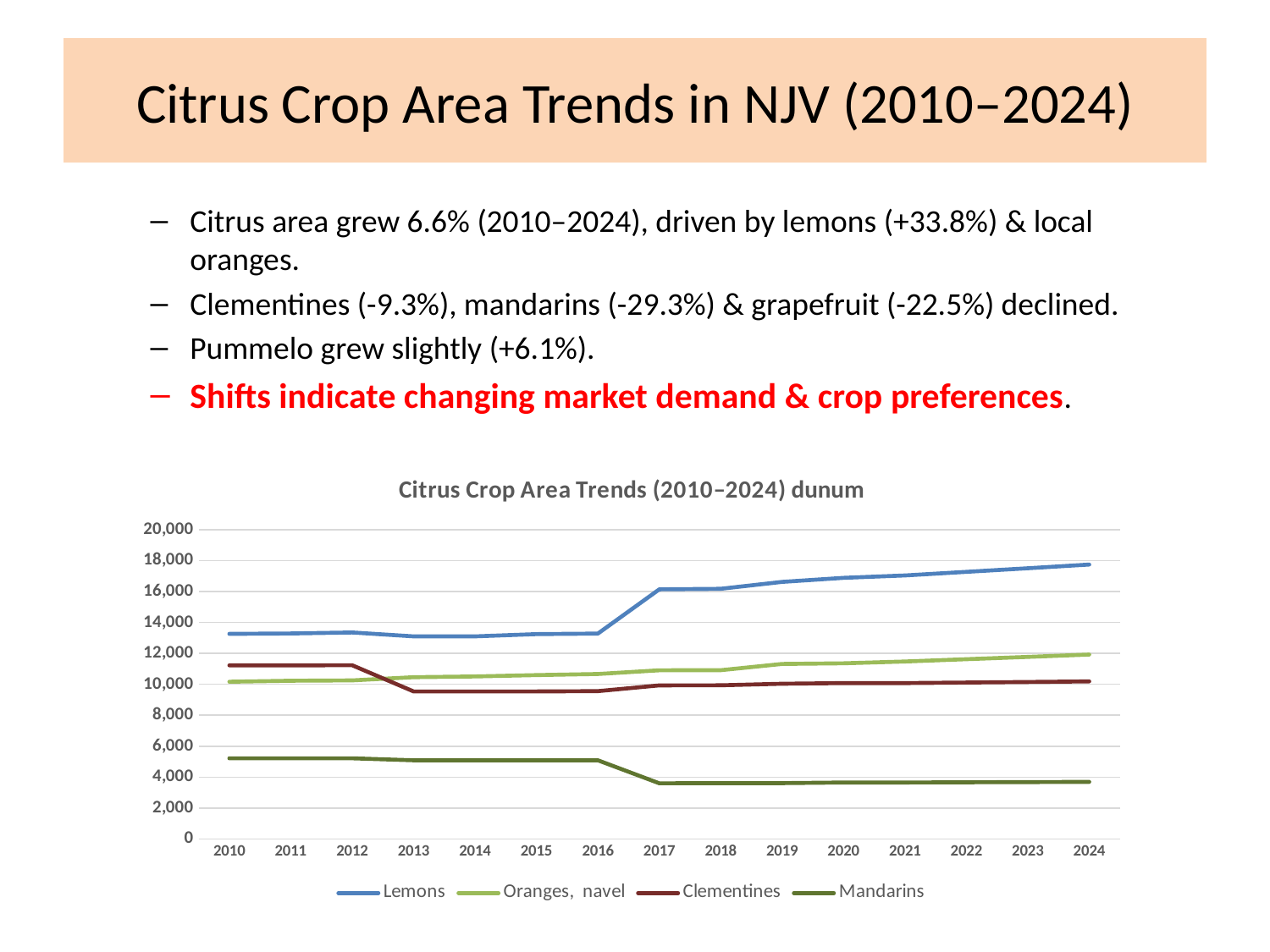
Is the value for Clementines in 2013 greater or less than 10,000? less Which series has the highest value in 2024? Lemons Is the value for Mandarins in 2024 greater or less than 4,000? less In 2020, which is larger: the value for Lemons or the value for Oranges, navel? Lemons What is the title of the chart? Citrus Crop Area Trends (2010–2024) dunum Do the values for Lemons rise or fall from 2010 to 2024? rise How many series does the chart legend list? 4 Do the values for Mandarins rise or fall from 2010 to 2024? fall Is the value for Lemons in 2024 greater or less than 16,000? greater Which series has the lowest value in 2024? Mandarins What kind of chart is shown on the slide? line chart How many years are shown along the x axis of the chart? 15